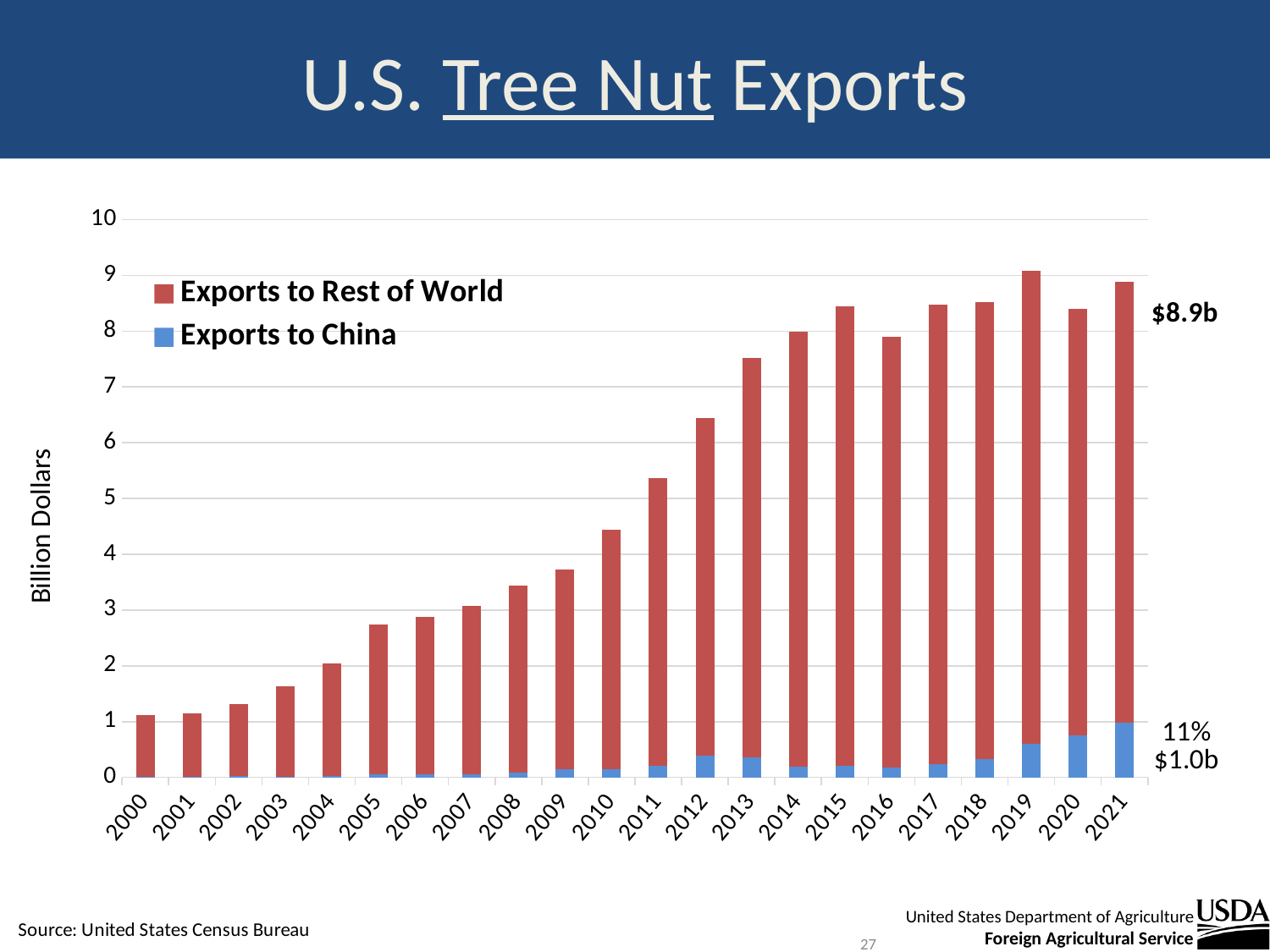
What is the value of exports to China labelled for 2021? $1.0b What is the total value of U.S. tree nut exports labelled for 2021? $8.9b What is the label on the y axis? Billion Dollars Is the total value for 2005 greater or less than 3? less What percentage share of 2021 tree nut exports went to China, according to the label? 11% Which year has larger total exports, 2015 or 2016? 2015 Do total tree nut exports generally rise or fall from 2000 to 2021? Rise How many series does the legend list? 2 Which year has the highest total tree nut exports? 2019 What kind of chart is shown on the slide? Bar chart How many years are shown along the x axis? 22 Is the total value for 2010 greater or less than 4? greater